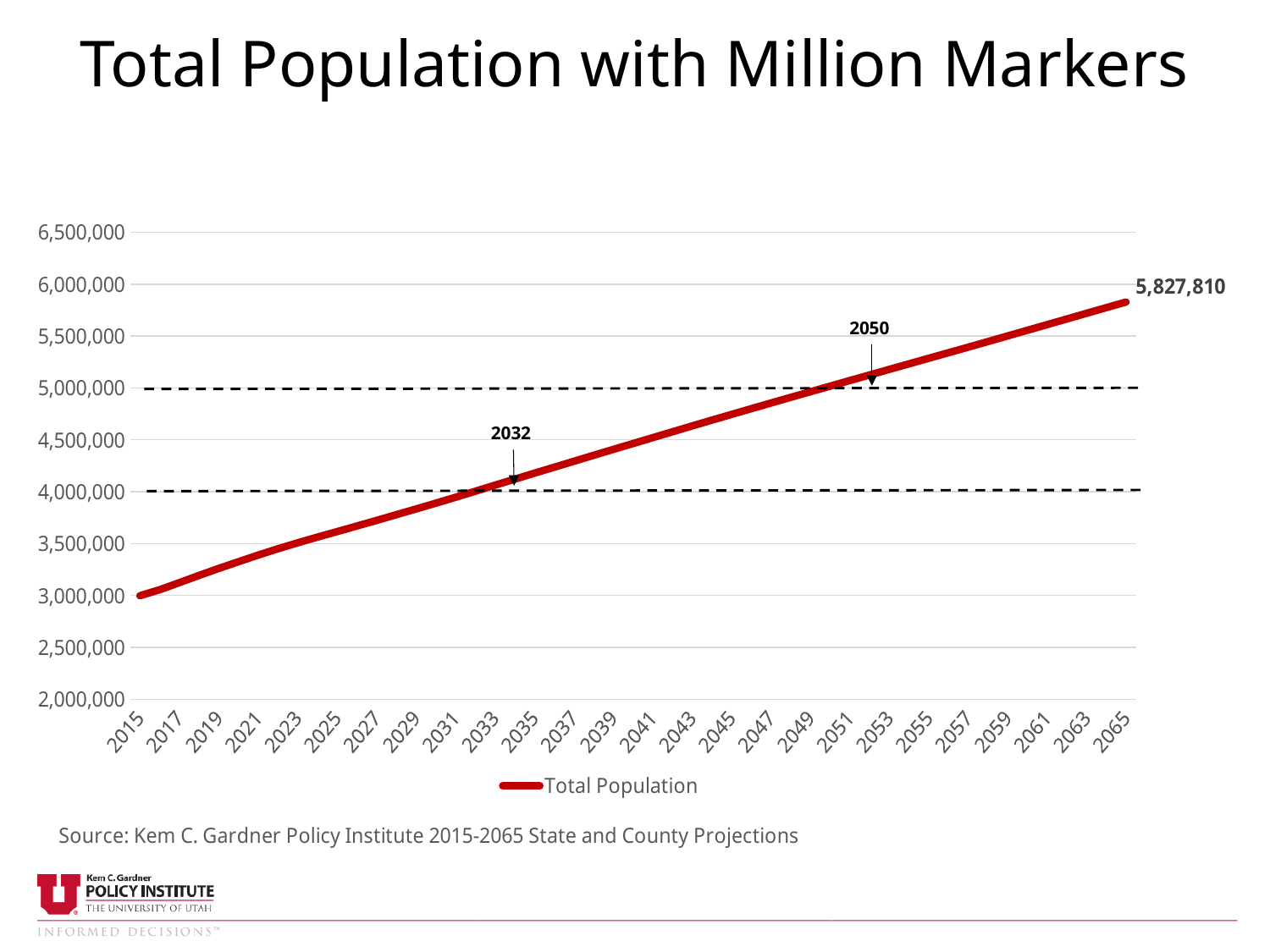
Does the Total Population rise or fall from 2015 to 2065? rise Is the Total Population in 2045 greater or less than 4,500,000? greater How many series does the legend list? 1 Which year is marked as the point where the Total Population crosses the 5,000,000 marker? 2050 What is the Total Population value labeled at the end of the line in 2065? 5,827,810 Which is larger, the Total Population in 2030 or in 2060? 2060 In which year is the Total Population highest? 2065 In which year is the Total Population lowest? 2015 Is the Total Population in 2015 greater or less than 3,500,000? less Is the Total Population in 2055 greater or less than 5,000,000? greater Which year is marked as the point where the Total Population crosses the 4,000,000 marker? 2032 What type of chart is shown on the slide? line chart